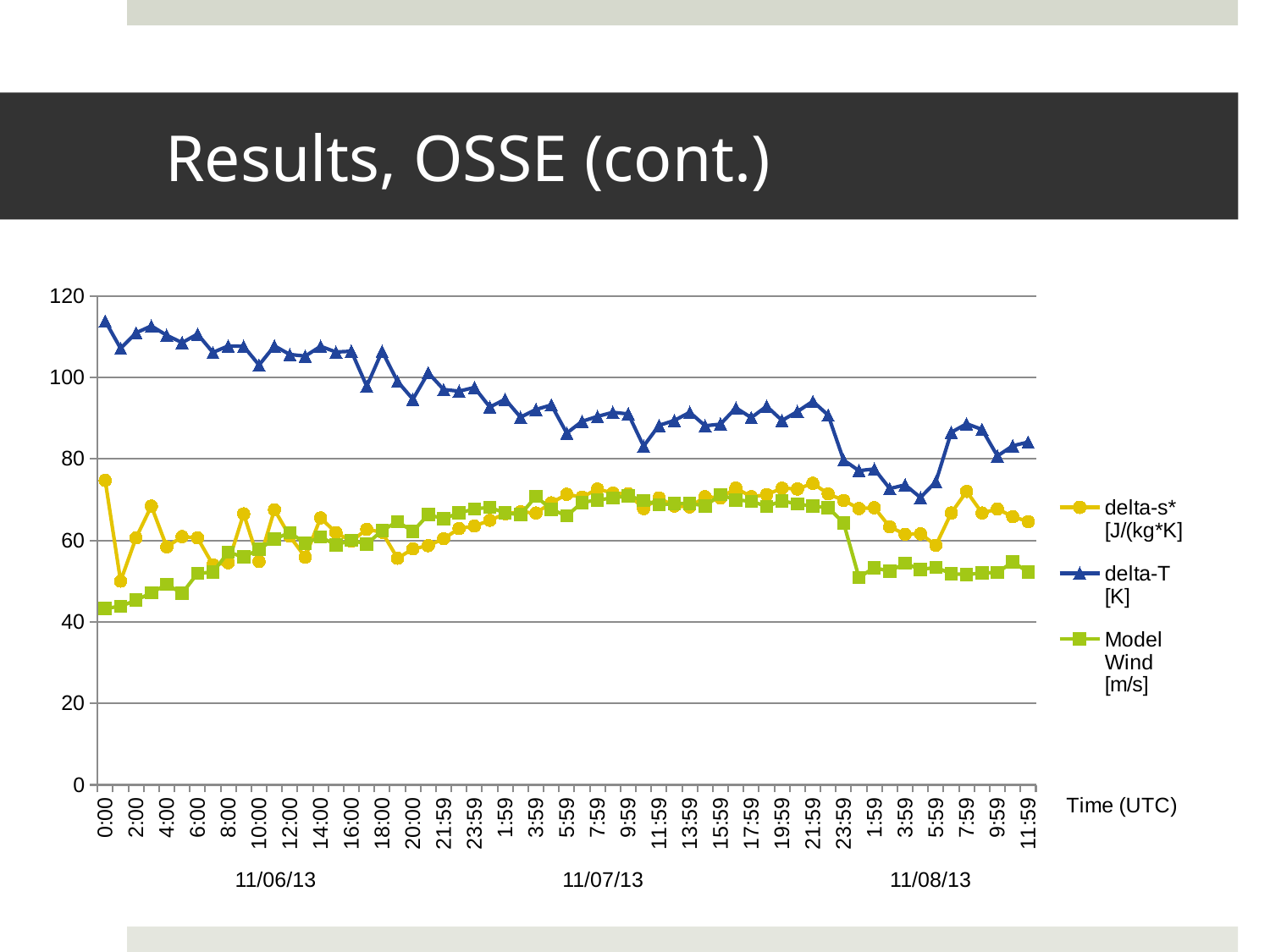
Is the value of delta-T [K] at 0:00 on 11/06/13 greater or less than 100? greater What kind of chart is shown on the slide? line chart What is the title of the x axis? Time (UTC) What are the three series named in the legend? delta-s* [J/(kg*K], delta-T [K], Model Wind [m/s] Which series has the lowest value at 0:00 on 11/06/13? Model Wind [m/s] Which series has the highest values across the whole chart? delta-T [K] How many series does the legend list? 3 Does delta-T [K] generally rise or fall from the start of 11/06/13 to the end of 11/08/13? fall Is the value of delta-T [K] at 3:59 on 11/08/13 greater or less than 80? less At 0:00 on 11/06/13, which is larger, delta-s* [J/(kg*K)] or Model Wind [m/s]? delta-s* [J/(kg*K)] Is the value of Model Wind [m/s] at 0:00 on 11/06/13 greater or less than 60? less